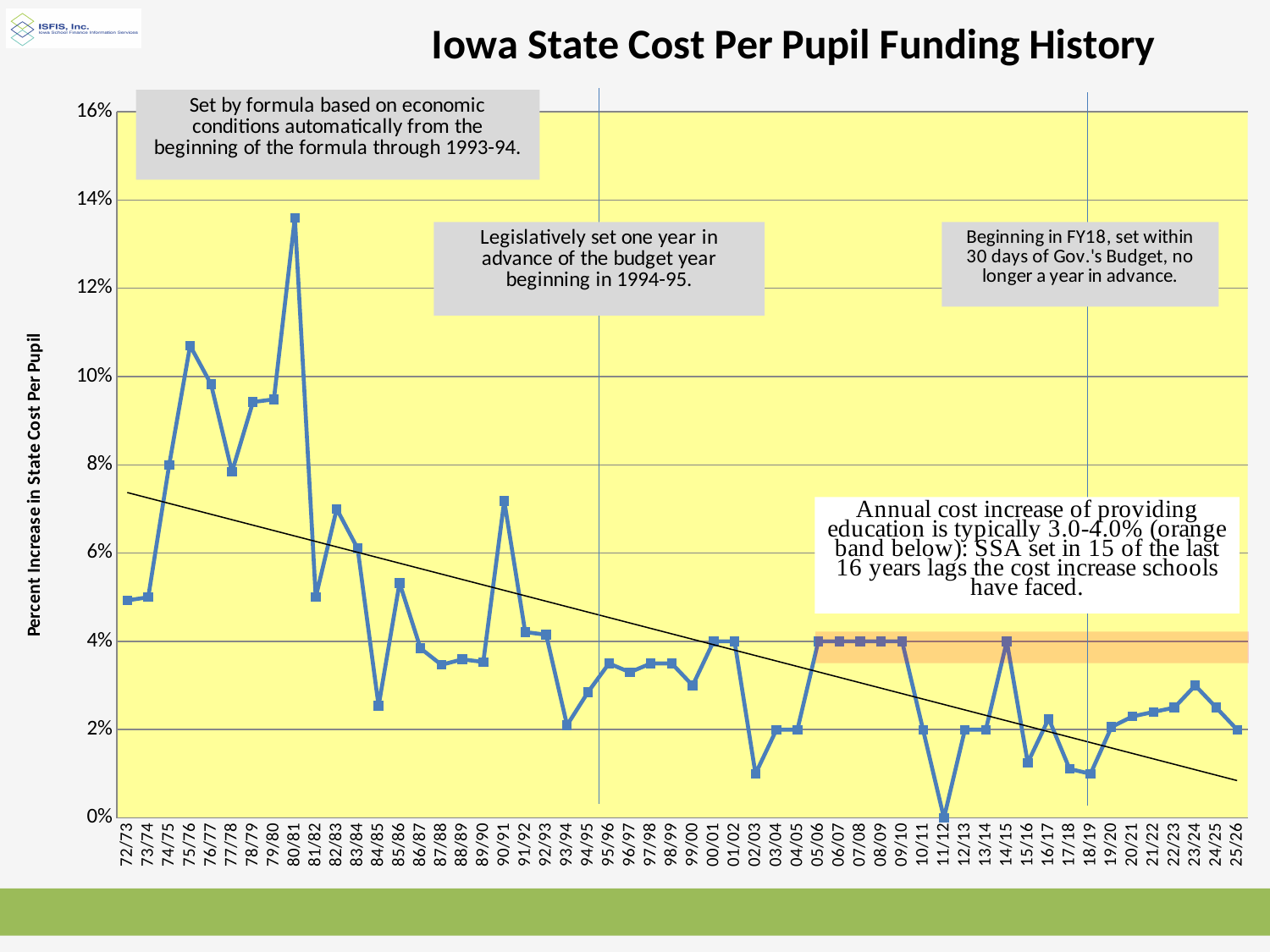
Is the value for 90/91 greater or less than 6%? greater Is the value for 02/03 greater or less than 2%? less Which year has the highest percent increase in state cost per pupil? 80/81 What is the label on the vertical axis? Percent Increase in State Cost Per Pupil Is the value for 75/76 greater or less than 10%? greater What is the percent increase for 11/12? 0% Overall, do the values rise or fall from 72/73 to 25/26? fall Which year has the lowest percent increase in state cost per pupil? 11/12 Which year has a larger percent increase, 80/81 or 81/82? 80/81 What kind of chart is shown on the slide? line chart What is the title of the chart? Iowa State Cost Per Pupil Funding History